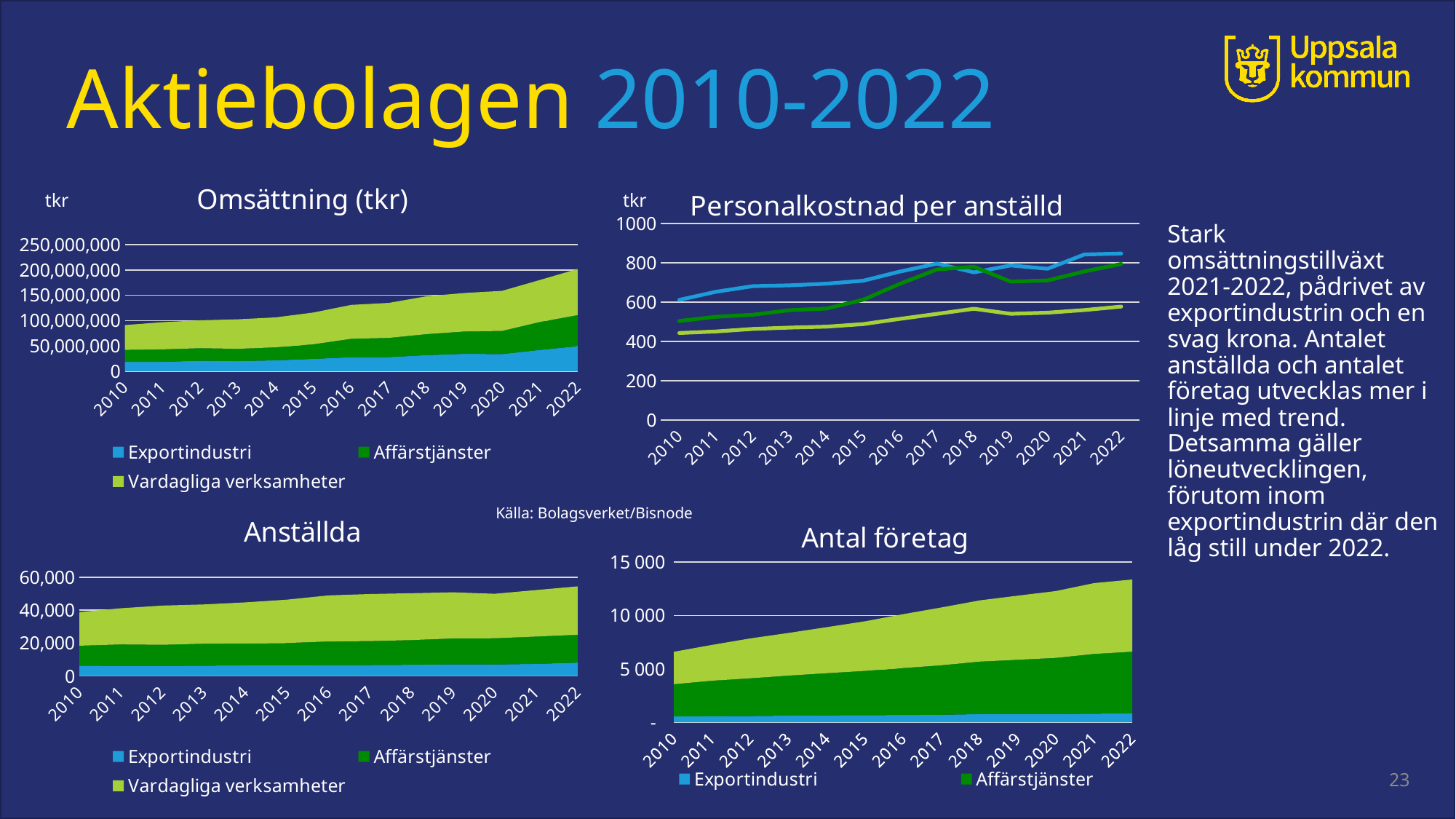
In the "Anställda" chart, is the total value for 2022 greater or less than 40,000? greater In the "Omsättning (tkr)" chart, is the total value for 2022 greater or less than 150,000,000? greater How many lines are plotted in the "Personalkostnad per anställd" chart? 3 In the "Personalkostnad per anställd" chart, is the value of the blue line for 2022 greater or less than 800? greater How many years are shown on the x axis of the "Omsättning (tkr)" chart? 13 What kind of chart is the "Omsättning (tkr)" chart? area chart How many series does the legend of the "Omsättning (tkr)" chart list? 3 What kind of chart is the "Personalkostnad per anställd" chart? line chart How many series does the legend of the "Antal företag" chart list? 2 In the "Omsättning (tkr)" chart, does the total rise or fall from 2010 to 2022? rises